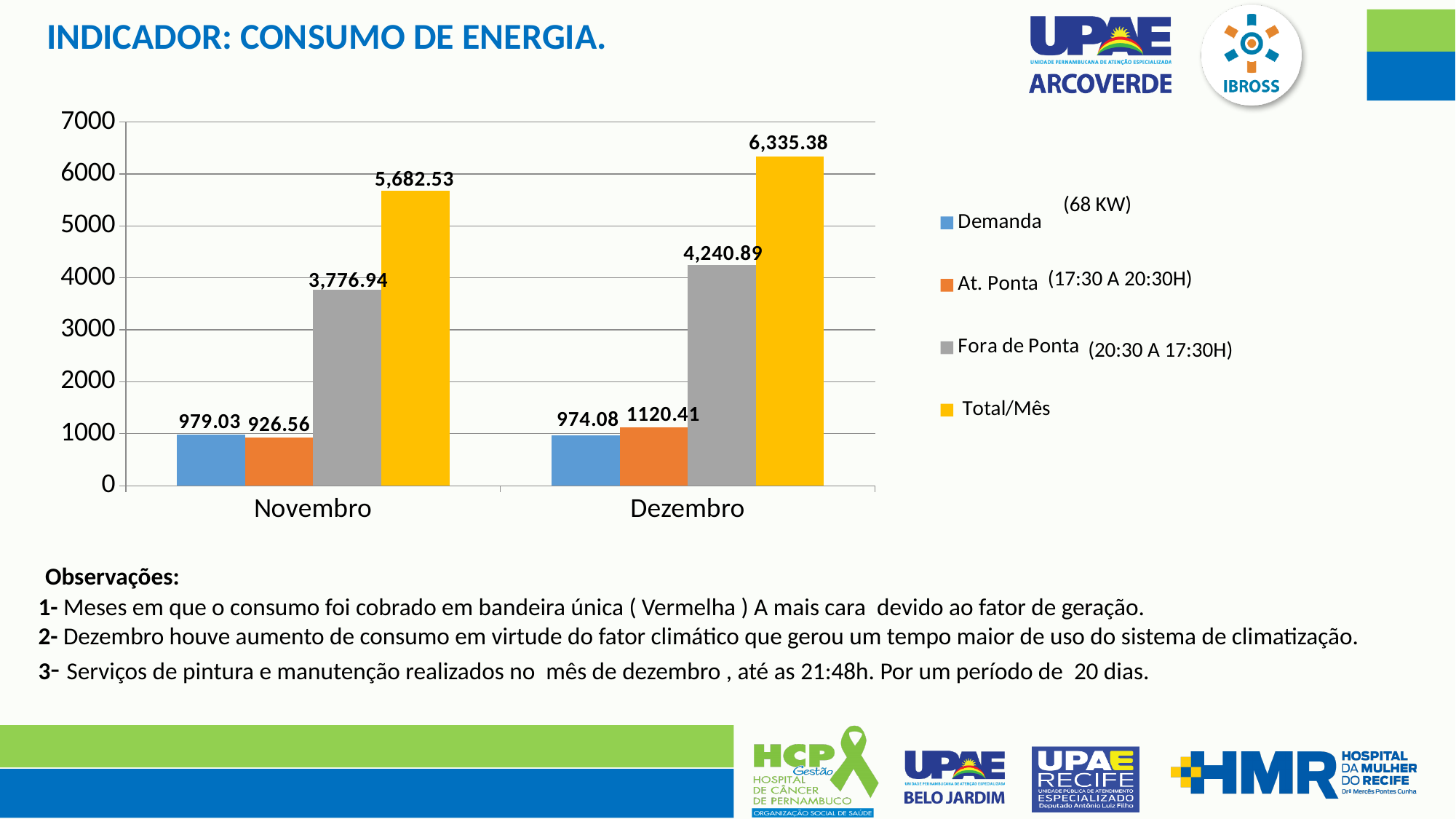
Which month has the higher Total/Mês value? Dezembro Is the Fora de Ponta value for Dezembro greater or less than 4000? greater Which series has the lowest value in Novembro? At. Ponta How many series does the legend list? 4 What is the value of Demanda for Novembro? 979.03 What is the value of Total/Mês for Dezembro? 6,335.38 How many months are shown on the x axis? 2 What is the value of Fora de Ponta for Novembro? 3,776.94 What kind of chart is shown on the slide? Bar chart What is the difference between the Total/Mês values for Dezembro and Novembro? 652.85 What is the difference between the Fora de Ponta values for Dezembro and Novembro? 463.95 What is the value of At. Ponta for Dezembro? 1120.41